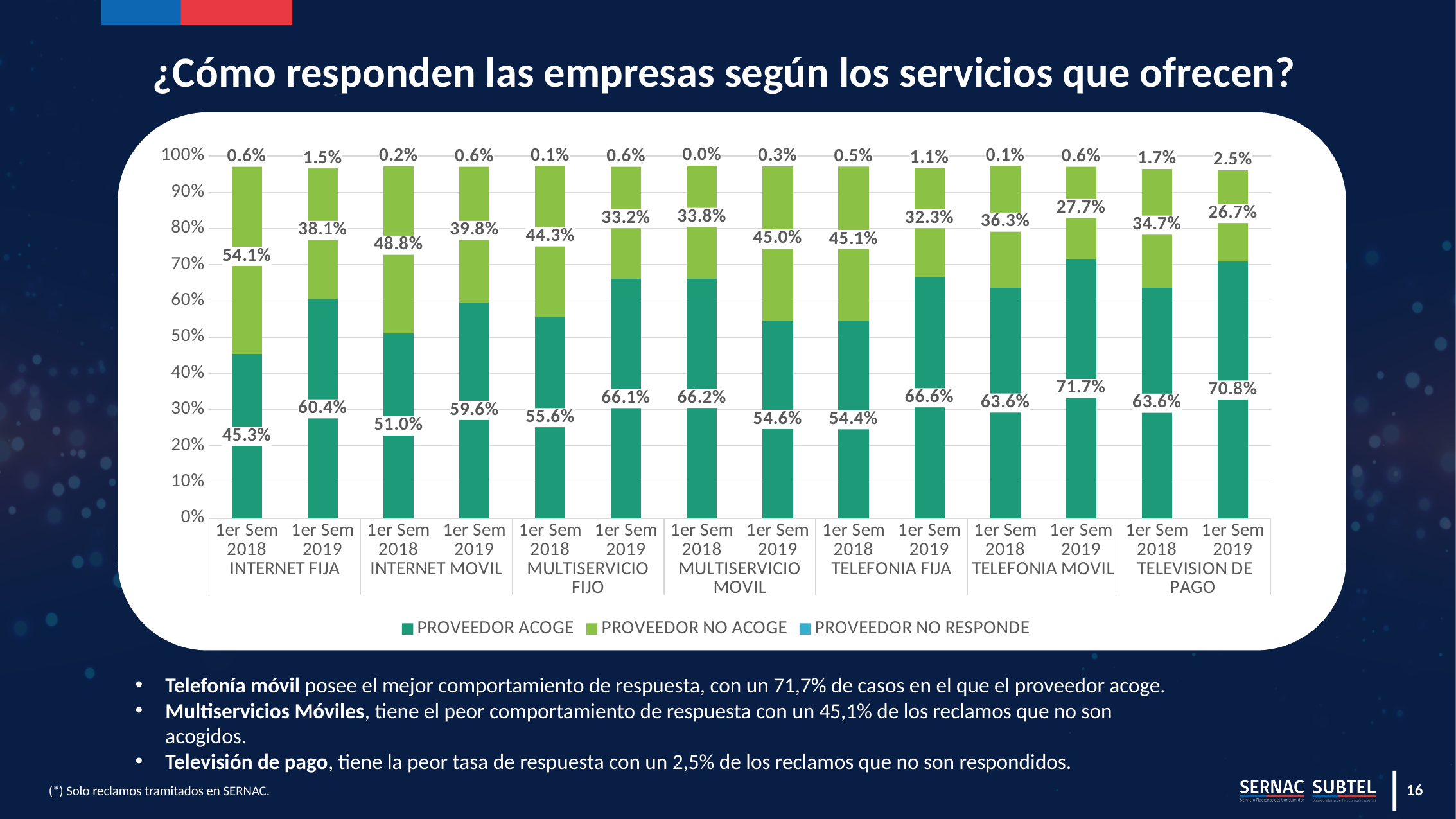
What kind of chart is shown on the slide? Stacked bar chart Which bar has the highest PROVEEDOR ACOGE value? TELEFONIA MOVIL 1er Sem 2019 What is the PROVEEDOR ACOGE value for TELEFONIA MOVIL in 1er Sem 2019? 71.7% How many series does the legend list? 3 What is the PROVEEDOR NO ACOGE value for INTERNET FIJA in 1er Sem 2018? 54.1% Which is larger: the PROVEEDOR NO ACOGE value for MULTISERVICIO MOVIL in 1er Sem 2019 or in 1er Sem 2018? 1er Sem 2019 What is the PROVEEDOR ACOGE value for MULTISERVICIO MOVIL in 1er Sem 2018? 66.2% By how many percentage points did the PROVEEDOR ACOGE value for INTERNET FIJA change from 1er Sem 2018 to 1er Sem 2019? 15.1% Which bar has the lowest PROVEEDOR ACOGE value? INTERNET FIJA 1er Sem 2018 How many bars are shown in the chart? 14 What is the PROVEEDOR NO RESPONDE value for TELEVISION DE PAGO in 1er Sem 2019? 2.5% Which bar has the highest PROVEEDOR NO RESPONDE value? TELEVISION DE PAGO 1er Sem 2019